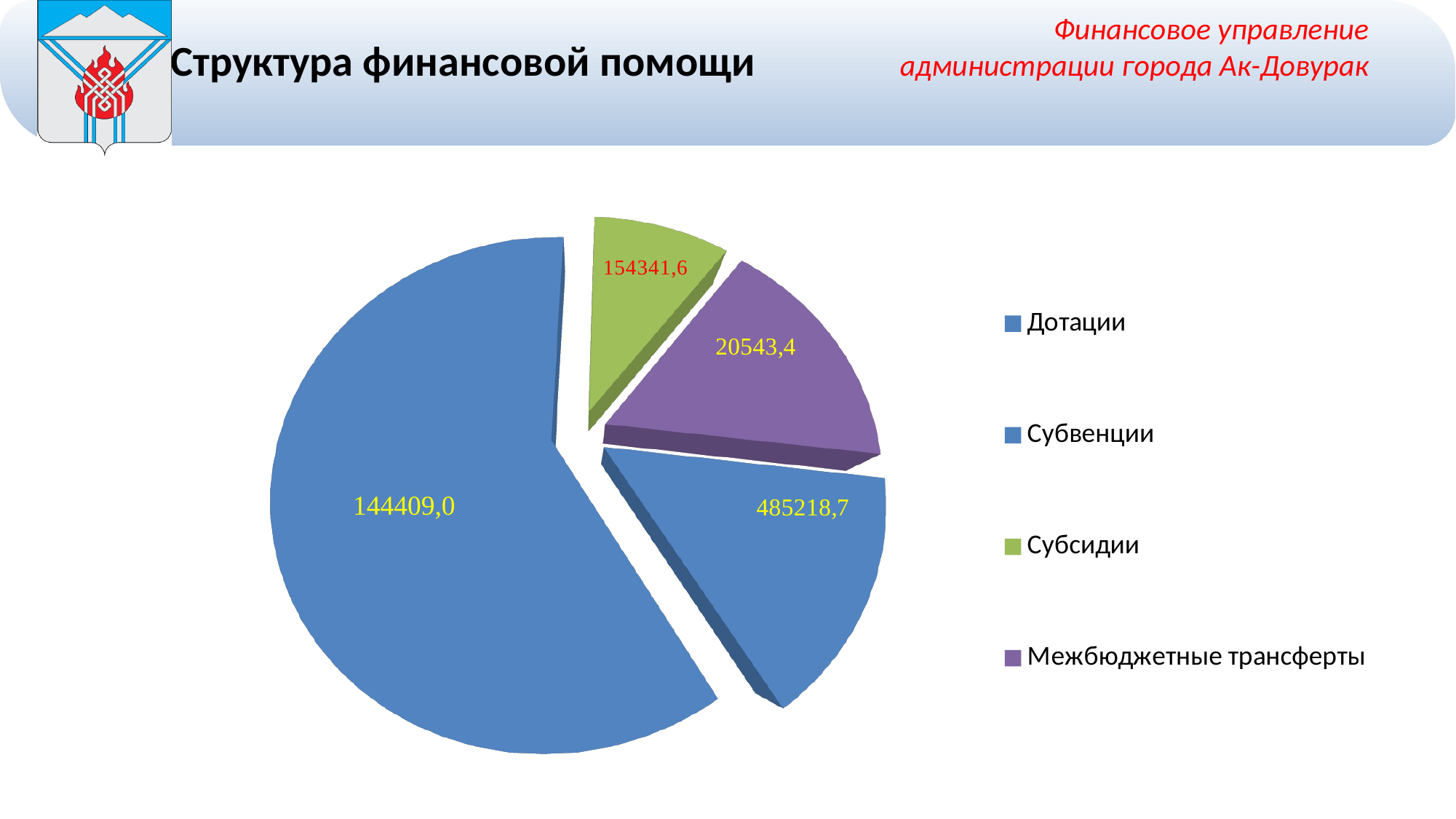
What is the title of the chart on the slide? Структура финансовой помощи What kind of chart is shown on the slide? Pie chart What value is printed on the Субсидии (green) slice? 154341,6 What is the difference between the Субсидии value and the Межбюджетные трансферты value? 133798,2 Which slice is the smallest in the pie chart? Субсидии Which is larger, Субсидии or Межбюджетные трансферты? Межбюджетные трансферты How many entries does the legend list? 4 What value is printed on the Межбюджетные трансферты (purple) slice? 20543,4 How many slices does the pie chart have? 4 Which legend entry is shown in green? Субсидии